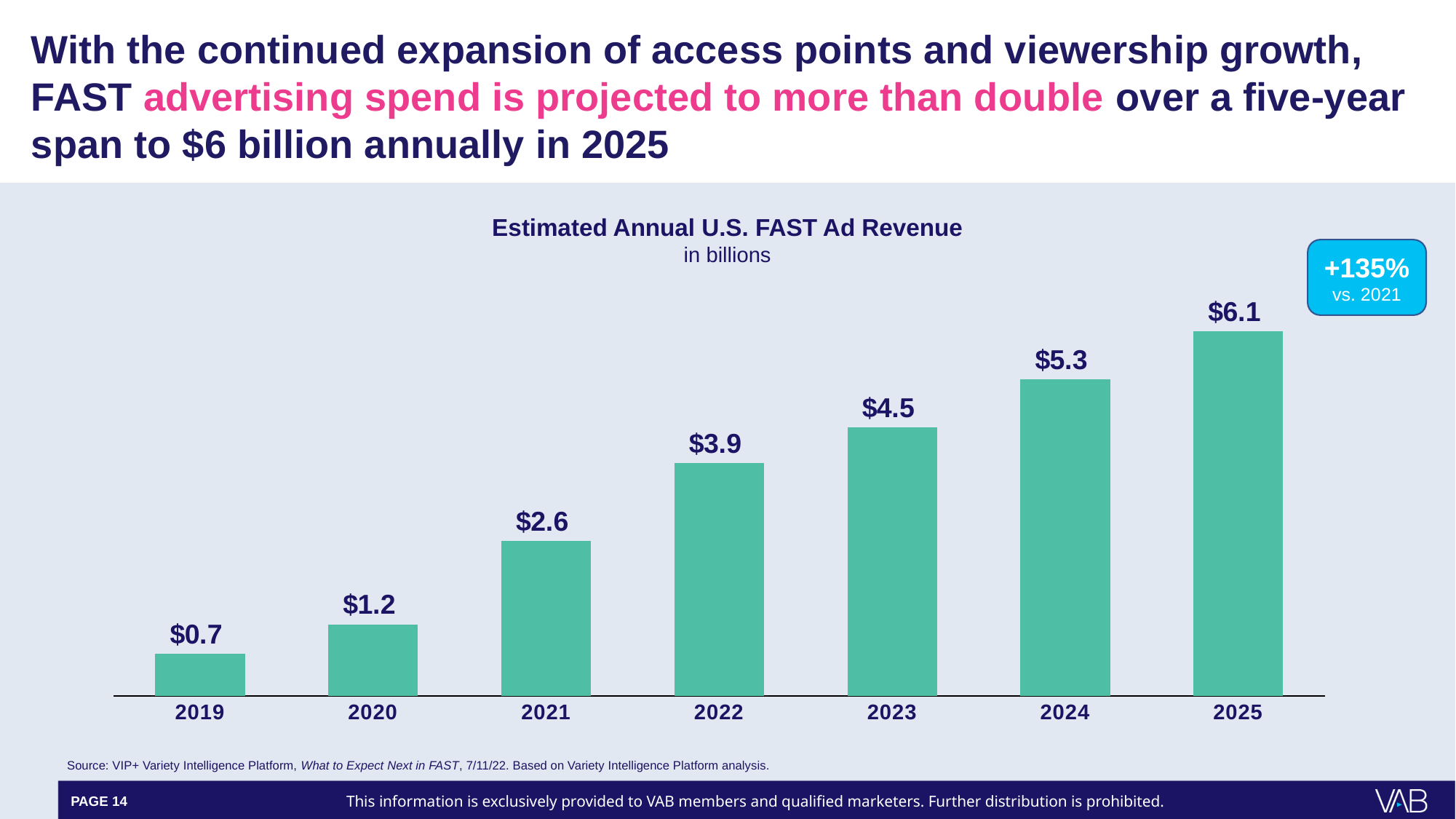
What type of chart is used to show the estimated annual U.S. FAST ad revenue? Bar chart Which year has a larger estimated FAST ad revenue, 2020 or 2022? 2022 What is the estimated annual U.S. FAST ad revenue for 2021? $2.6 Which year has the highest estimated FAST ad revenue? 2025 What percentage growth vs. 2021 is highlighted in the callout on the chart? +135% Which year has the lowest estimated FAST ad revenue? 2019 How many years are shown on the chart? 7 What is the estimated annual U.S. FAST ad revenue for 2025? $6.1 What is the estimated annual U.S. FAST ad revenue for 2019? $0.7 What is the difference in estimated FAST ad revenue between 2023 and 2022? $0.6 What is the difference in estimated FAST ad revenue between 2025 and 2021? $3.5 Do the estimated FAST ad revenue values rise or fall from 2019 to 2025? Rise